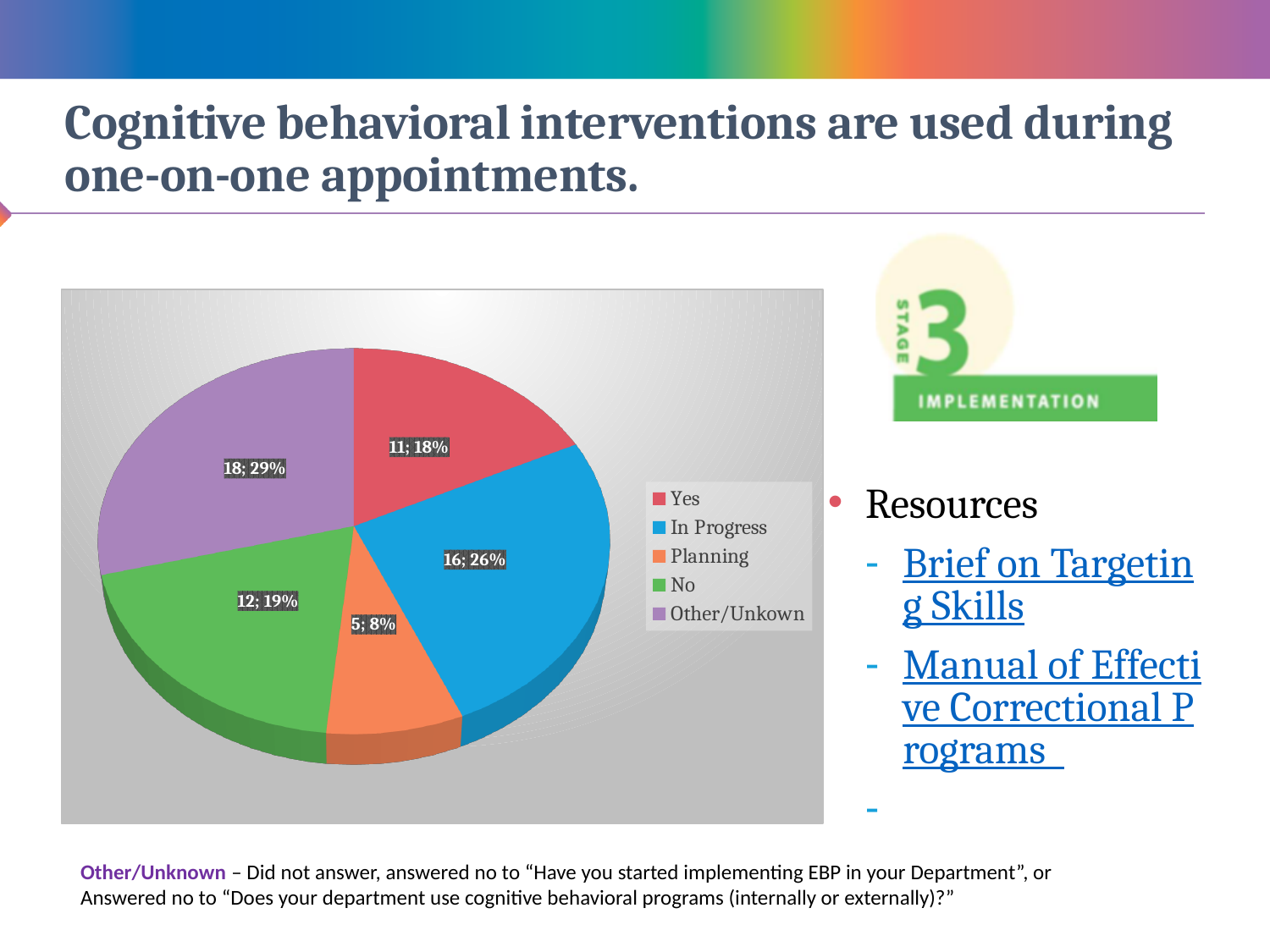
What is the count for the 'Yes' slice? 11 Which category has the smallest slice of the pie? Planning How many slices does the pie chart have? 5 Which is larger, the count for 'In Progress' or the count for 'No'? In Progress Which category has the largest slice of the pie? Other/Unkown What is the count for the 'Planning' slice? 5 What is the total count across all slices of the pie? 62 What percentage of the pie does 'In Progress' represent? 26% What is the difference between the counts for 'Other/Unkown' and 'Yes'? 7 What colour is the 'Other/Unkown' slice in the pie chart? purple What percentage of the pie does 'No' represent? 19% What kind of chart is shown on the slide? pie chart